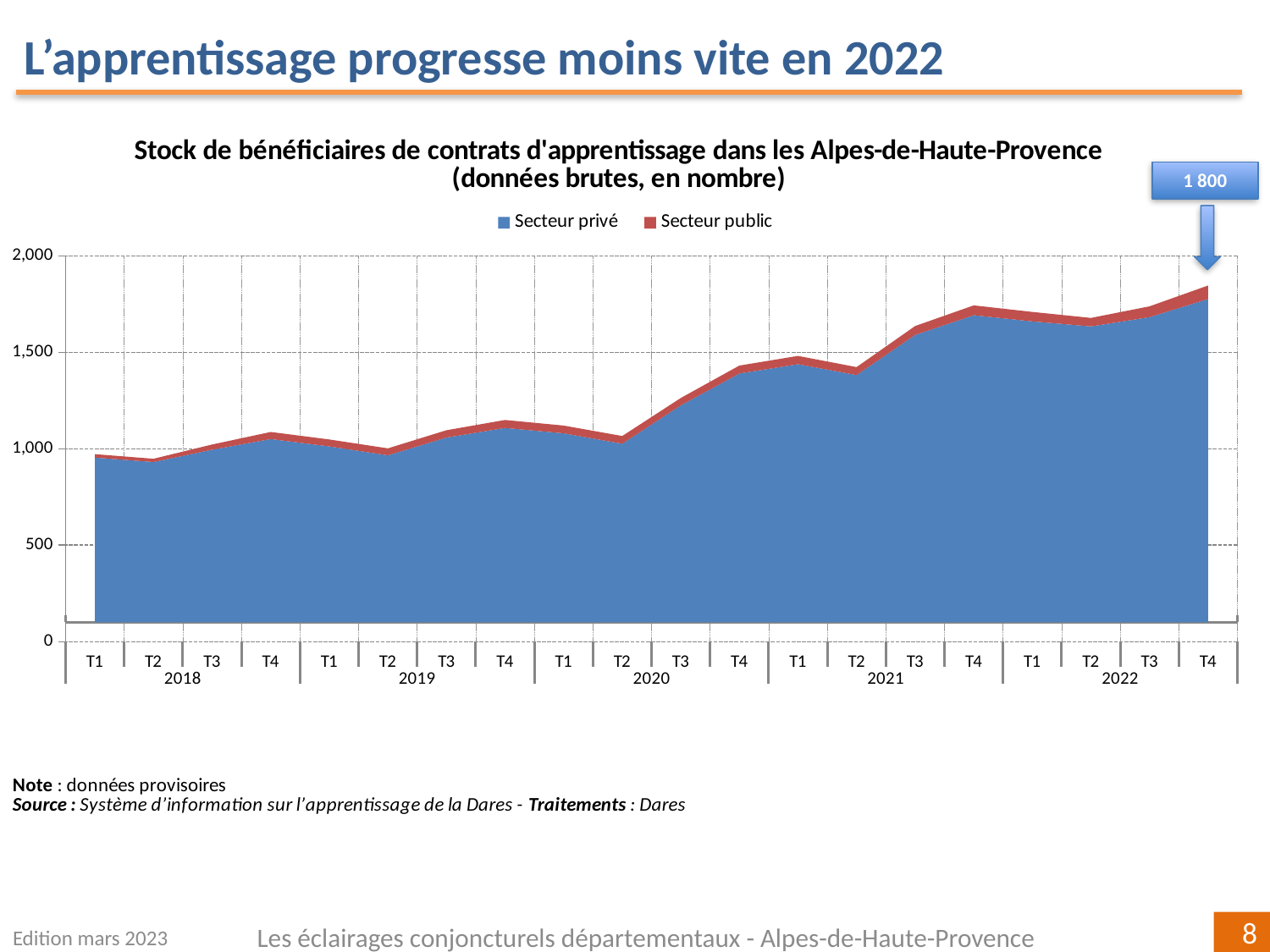
Is the total value for T4 2021 greater or less than 1,500? greater Is the total value for T4 2020 greater or less than 1,500? less Which series accounts for the larger share of the stock, Secteur privé or Secteur public? Secteur privé What are the two series named in the legend? Secteur privé and Secteur public Overall, does the total stock rise or fall from 2018 to 2022? Rise Is the total value for T2 2018 greater or less than 1,000? less What total value is indicated by the callout for T4 2022? 1 800 In which quarter is the total stock of apprenticeship beneficiaries highest? T4 2022 What kind of chart is shown on the slide? Stacked area chart How many series does the legend list? 2 Which is larger, the total for T4 2020 or the total for T4 2021? T4 2021 How many quarterly points are plotted along the x axis? 20